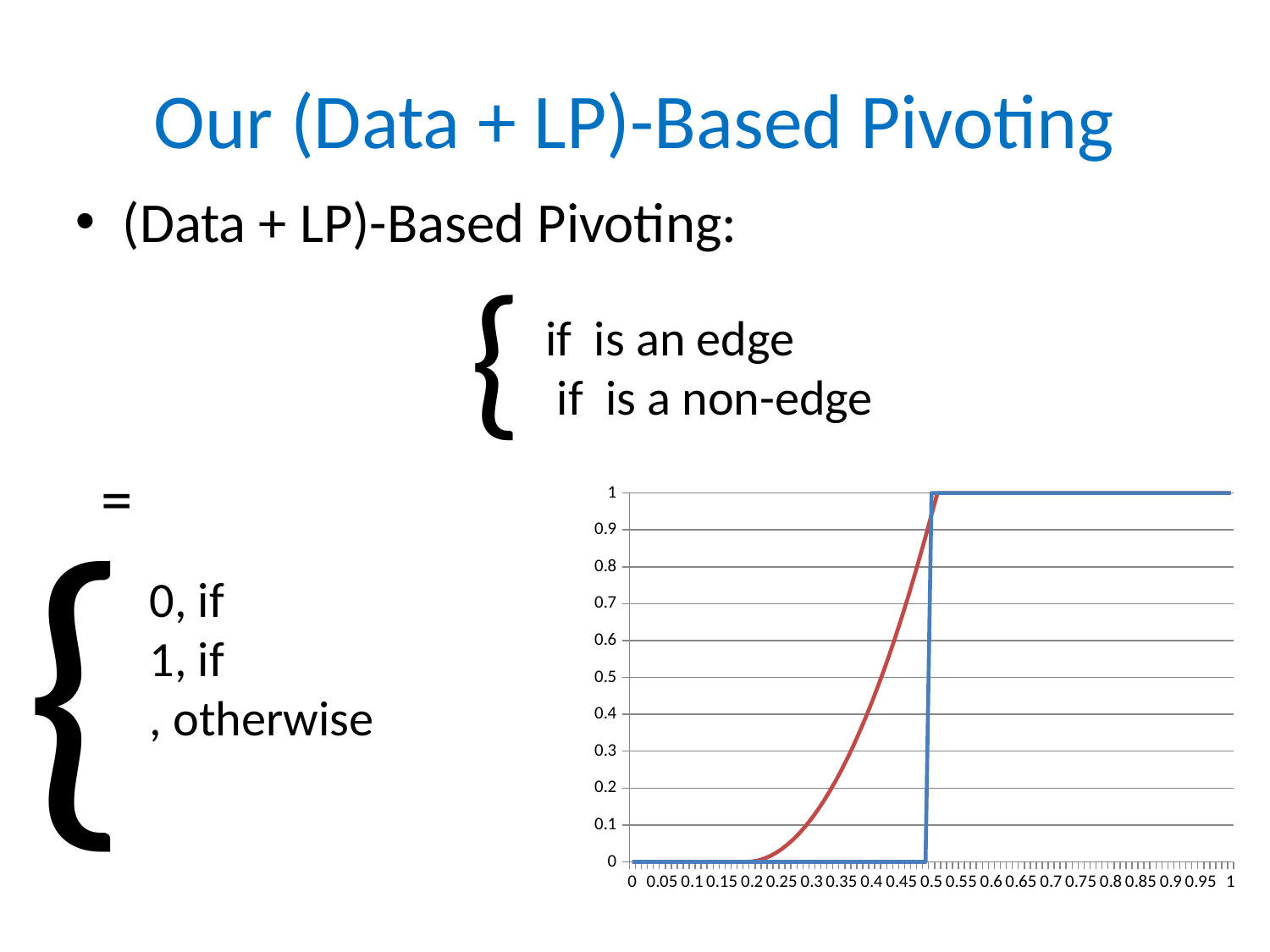
Do the values of the red line rise or fall as x increases from 0.2 to 0.5? rise What is the highest value shown on the chart's y axis? 1 How many lines are plotted on the chart? 2 What is the value of the blue line at x = 0.8? 1 Around which x value does the blue line jump from 0 to 1? 0.5 What colours are the two lines on the chart? blue and red At x = 0.4, which line has the larger value, the red line or the blue line? red line Is the value of the red line at x = 0.45 greater or less than 0.5? greater Is the value of the red line at x = 0.3 greater or less than 0.5? less What is the value of the blue line at x = 0.2? 0 Is the value of the blue line at x = 0.7 greater or less than 0.5? greater What kind of chart is shown on the slide? line chart